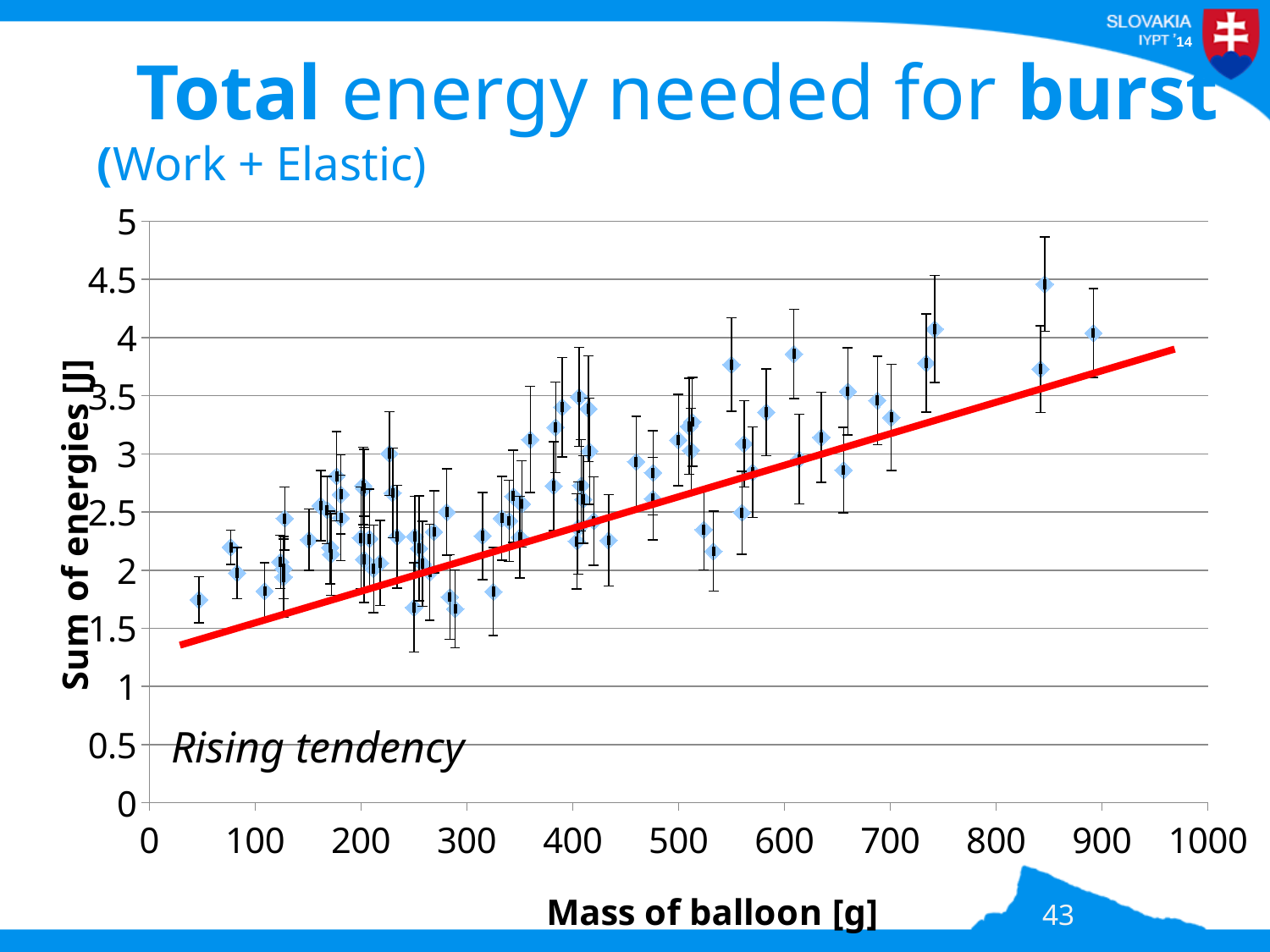
Is the lowest plotted point on the chart greater or less than 2 J? less What is the label of the y axis? Sum of energies [J] What is the label of the x axis? Mass of balloon [g] What is the maximum value shown on the y axis? 5 What kind of chart is shown on the slide? scatter chart Is the highest plotted point on the chart greater or less than 4 J? greater Is the value of the point plotted near 50 g greater or less than 2 J? less Do the plotted values rise or fall as the mass of the balloon increases along the x axis? rise